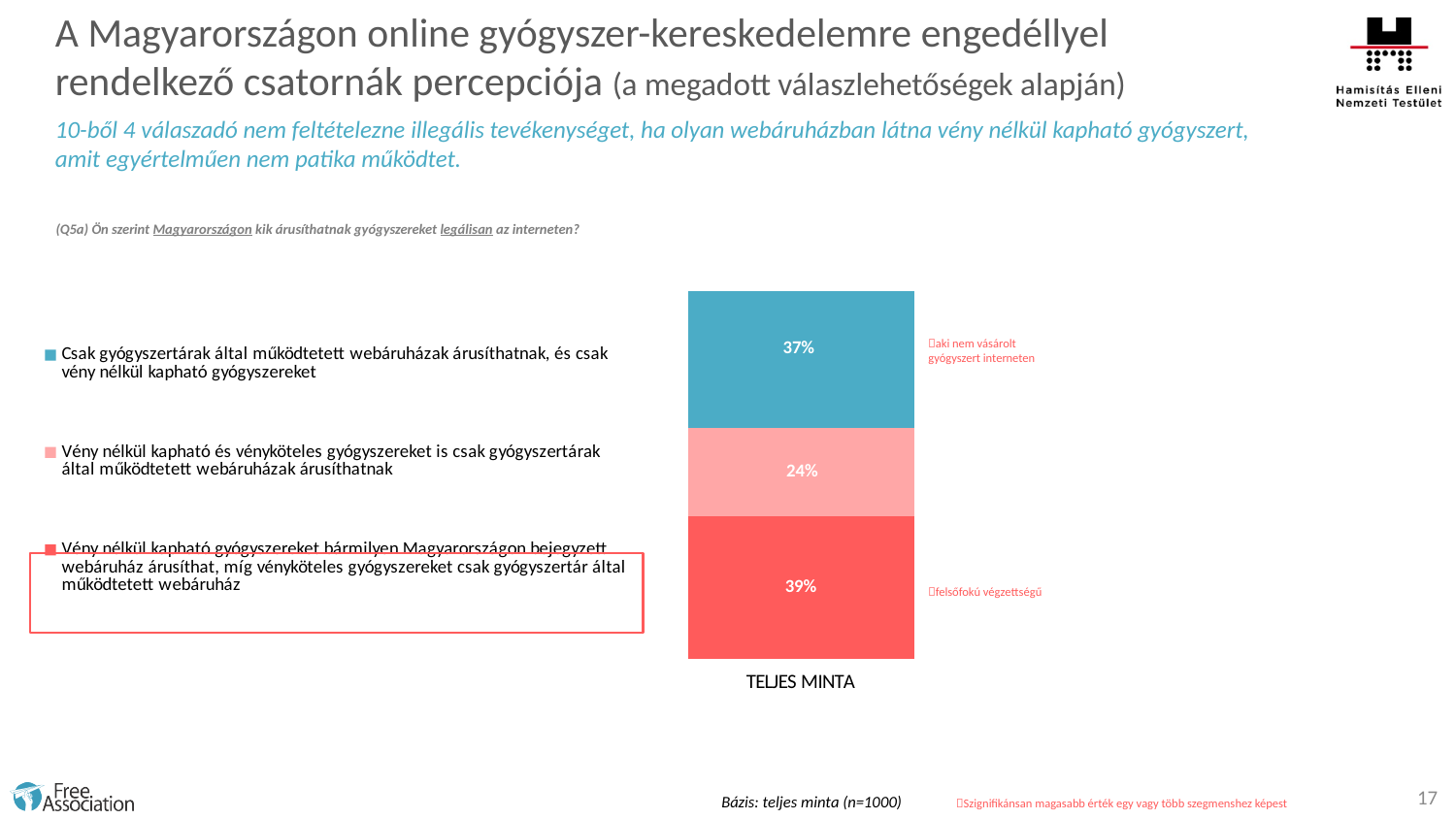
What is the total of the three segments in the stacked bar? 100% How many series does the legend list? 3 What is the value of the middle (light pink) segment of the bar for TELJES MINTA? 24% What is the value of the top (teal) segment of the bar for TELJES MINTA? 37% Which segment of the stacked bar has the smallest value? 24% (middle, light pink segment) What is the value of the bottom (red) segment of the bar for TELJES MINTA? 39% Which segment of the stacked bar has the largest value? 39% (bottom, red segment) Which is larger: the top (teal) segment or the bottom (red) segment? The bottom (red) segment, 39% What percentage is shown for the series 'Vény nélkül kapható és vényköteles gyógyszereket is csak gyógyszertárak által működtetett webáruházak árusíthatnak'? 24% What kind of chart is shown on the slide? Stacked bar chart What is the difference between the bottom (red) segment and the middle (light pink) segment? 15 percentage points What is the category label shown under the stacked bar? TELJES MINTA